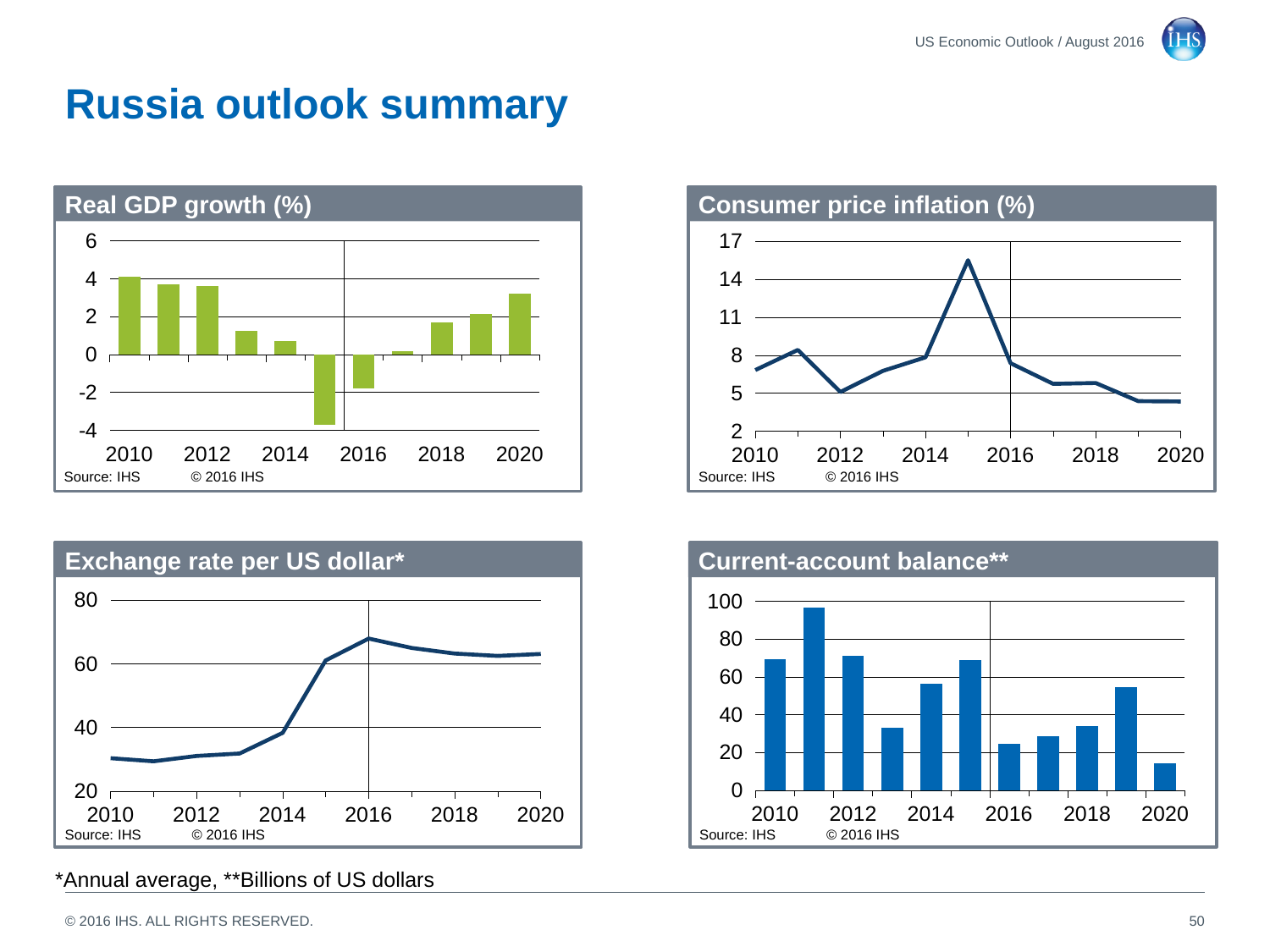
In the Current-account balance chart, which is larger, the value for 2016 or the value for 2019? 2019 In the Real GDP growth (%) chart, which year has the highest value? 2010 In the Exchange rate per US dollar chart, is the value for 2010 greater or less than 40? less In the Consumer price inflation (%) chart, is the value for 2015 greater or less than 14? greater In the Real GDP growth (%) chart, is the value for 2015 greater or less than -2? less In the Current-account balance chart, which year has the lowest value? 2020 What kind of chart is the Consumer price inflation (%) chart? line chart In the Real GDP growth (%) chart, which year has the lowest value? 2015 In the Consumer price inflation (%) chart, which year has the highest value? 2015 In the Current-account balance chart, which year has the highest value? 2011 In the Real GDP growth (%) chart, how many years are plotted? 11